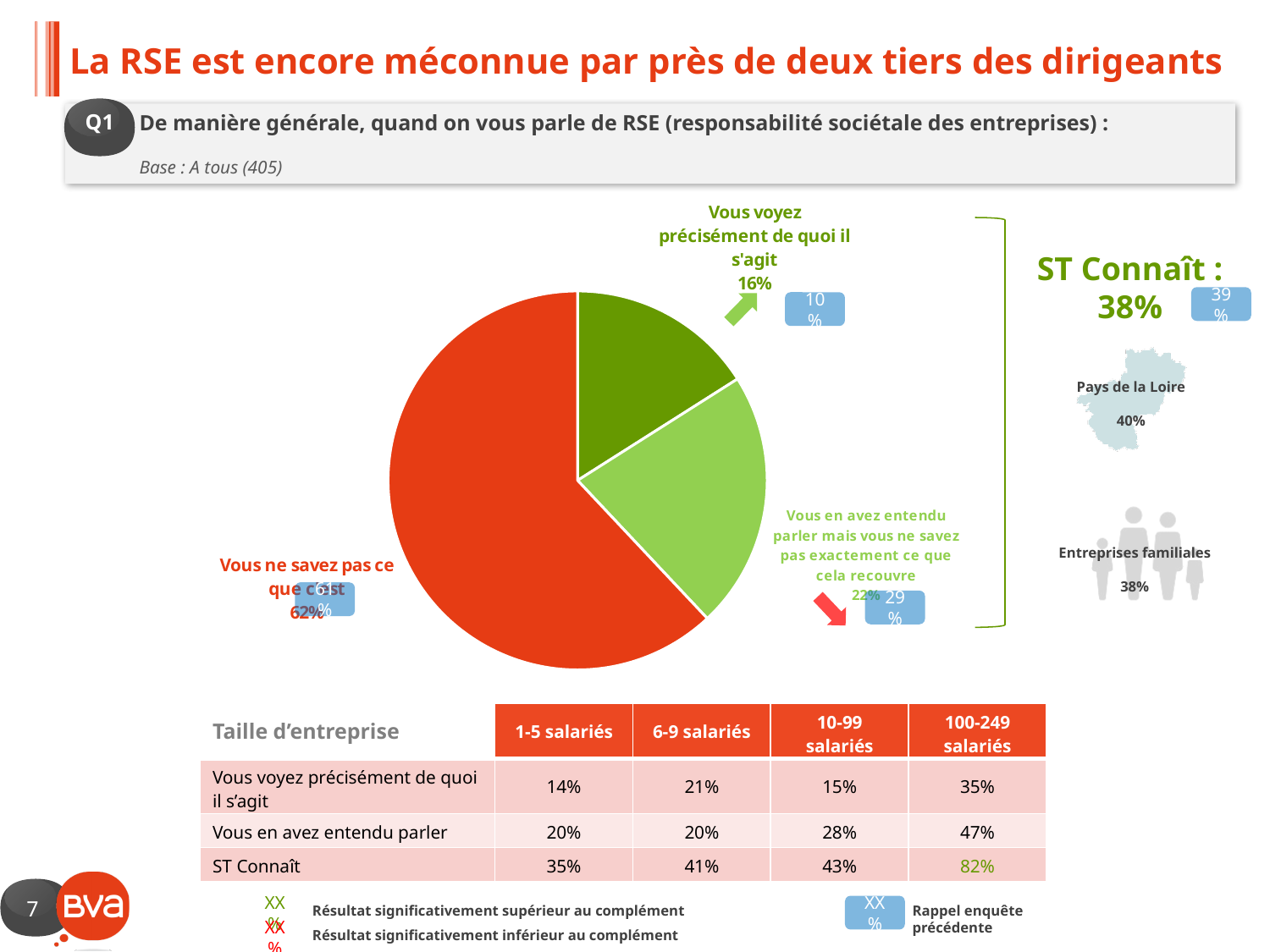
What share of the pie does the "Vous ne savez pas ce que c'est" slice represent? 62% What percentage of respondents answered "Vous ne savez pas ce que c'est"? 62% What colour is the largest slice of the pie chart? red What percentage of respondents answered "Vous en avez entendu parler mais vous ne savez pas exactement ce que cela recouvre"? 22% Which response has the smallest slice of the pie chart? Vous voyez précisément de quoi il s'agit What is the difference in percentage points between "Vous ne savez pas ce que c'est" and "Vous voyez précisément de quoi il s'agit"? 46 percentage points Which is larger: the share for "Vous en avez entendu parler mais vous ne savez pas exactement ce que cela recouvre" or for "Vous voyez précisément de quoi il s'agit"? Vous en avez entendu parler mais vous ne savez pas exactement ce que cela recouvre What is the difference in percentage points between "Vous en avez entendu parler mais vous ne savez pas exactement ce que cela recouvre" and "Vous voyez précisément de quoi il s'agit"? 6 percentage points Which response has the largest slice of the pie chart? Vous ne savez pas ce que c'est What kind of chart is shown on the slide? pie chart What percentage of respondents answered "Vous voyez précisément de quoi il s'agit"? 16% How many slices does the pie chart have? 3